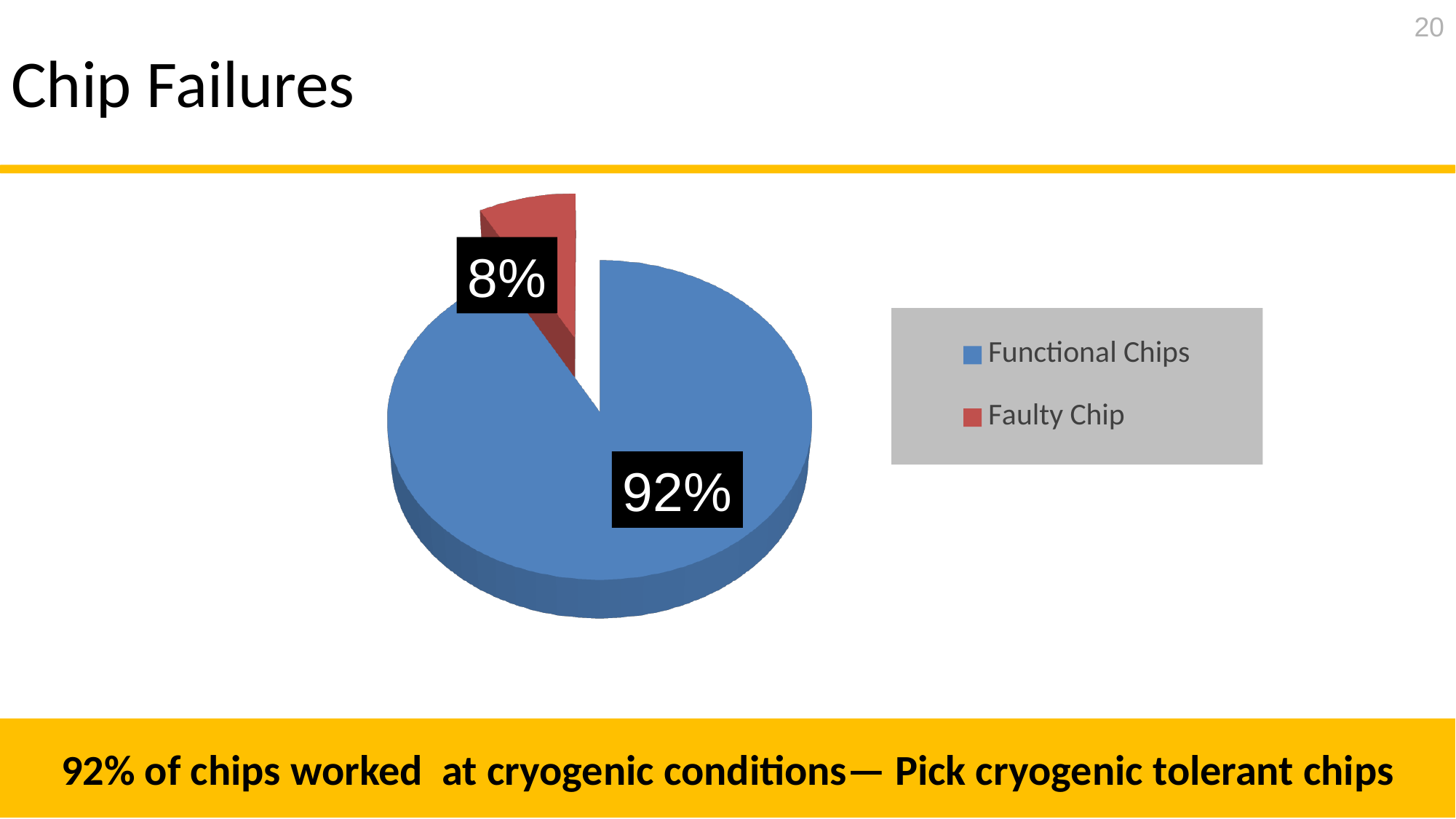
What kind of chart is shown on the slide? Pie chart What colour is the Functional Chips slice? Blue What share of the pie is Faulty Chip? 8% What share of the pie is Functional Chips? 92% What is the difference in percentage points between the Functional Chips slice and the Faulty Chip slice? 84 How many entries does the legend list? 2 Which slice of the pie is the largest? Functional Chips How many slices does the pie chart have? 2 Which slice of the pie is the smallest? Faulty Chip What colour is the Faulty Chip slice? Red Which is larger, the Functional Chips slice or the Faulty Chip slice? Functional Chips